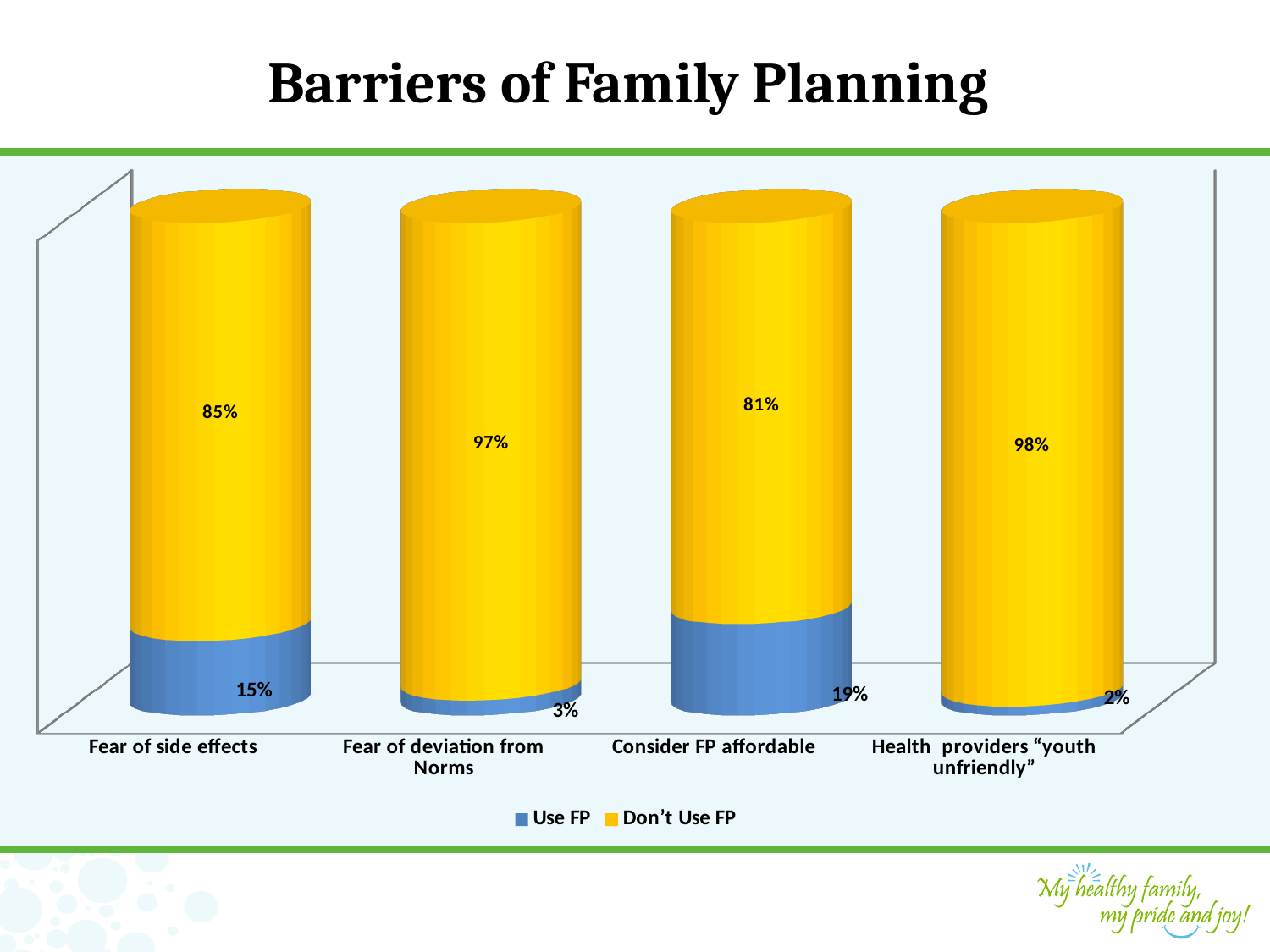
What is the title of the chart? Barriers of Family Planning How many categories are shown on the x axis? 4 Which category has the highest "Use FP" value? Consider FP affordable How many series does the legend list? 2 Which is larger: the "Use FP" value for "Fear of side effects" or for "Health providers "youth unfriendly""? Fear of side effects What is the "Use FP" value for "Consider FP affordable"? 19% What kind of chart is shown on the slide? Stacked bar chart What is the "Don't Use FP" value for "Fear of side effects"? 85% What is the "Don't Use FP" value for "Health providers "youth unfriendly""? 98% What is the difference between the "Don't Use FP" values for "Fear of deviation from Norms" and "Fear of side effects"? 12% Which category has the lowest "Don't Use FP" value? Consider FP affordable What is the "Use FP" value for "Fear of deviation from Norms"? 3%